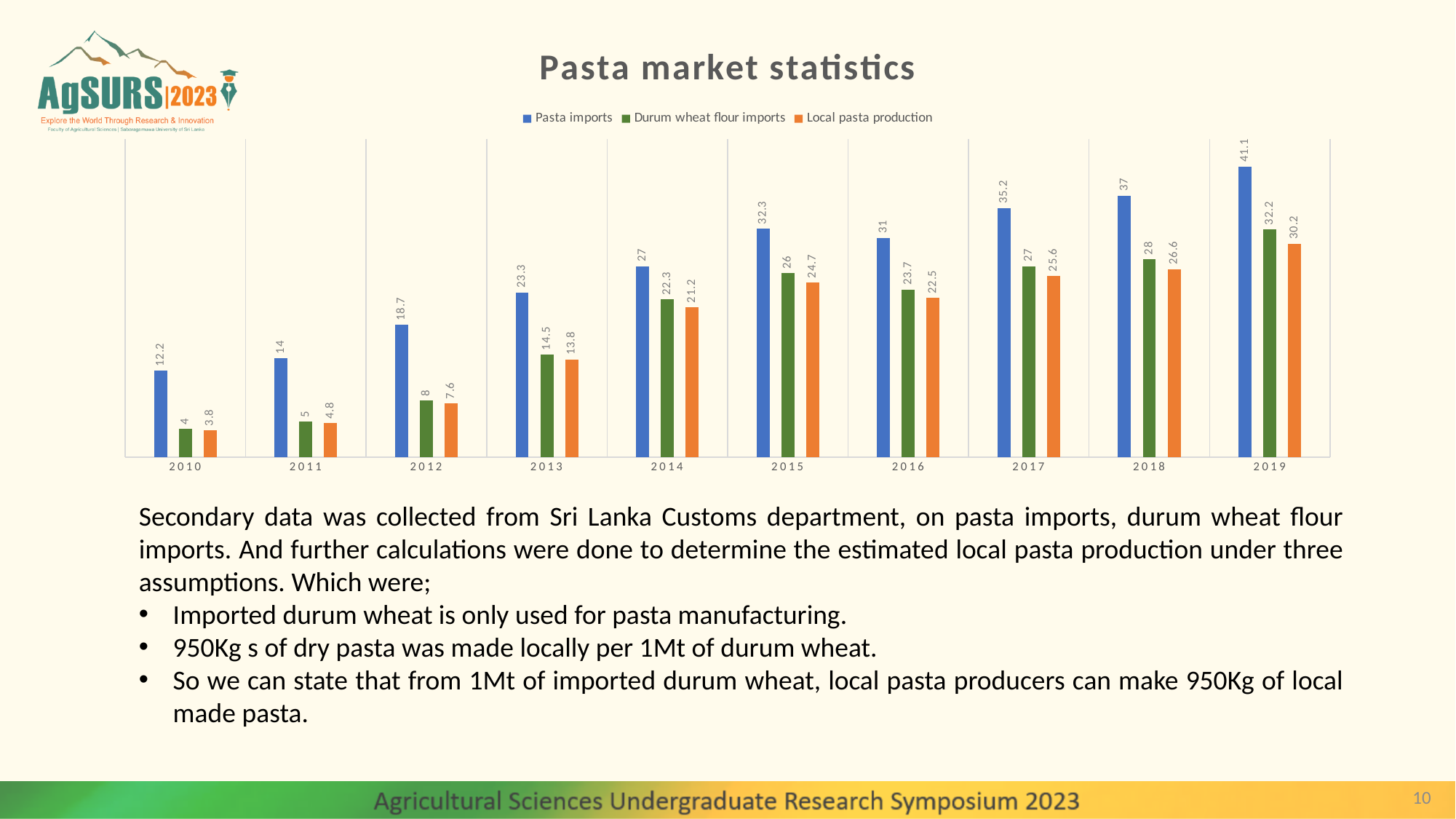
Which year has the lowest value for Local pasta production? 2010 What is the difference between Pasta imports and Durum wheat flour imports in 2018? 9 Do the Pasta imports values rise or fall from 2010 to 2019? Rise How many years are shown on the x axis? 10 Which is larger in 2016: Durum wheat flour imports or Local pasta production? Durum wheat flour imports What is the value of Durum wheat flour imports in 2015? 26 What is the value of Pasta imports in 2019? 41.1 How many series does the legend list? 3 Which year has the highest value for Pasta imports? 2019 What is the value of Local pasta production in 2012? 7.6 What kind of chart is shown on the slide? Bar chart What is the title of the chart? Pasta market statistics